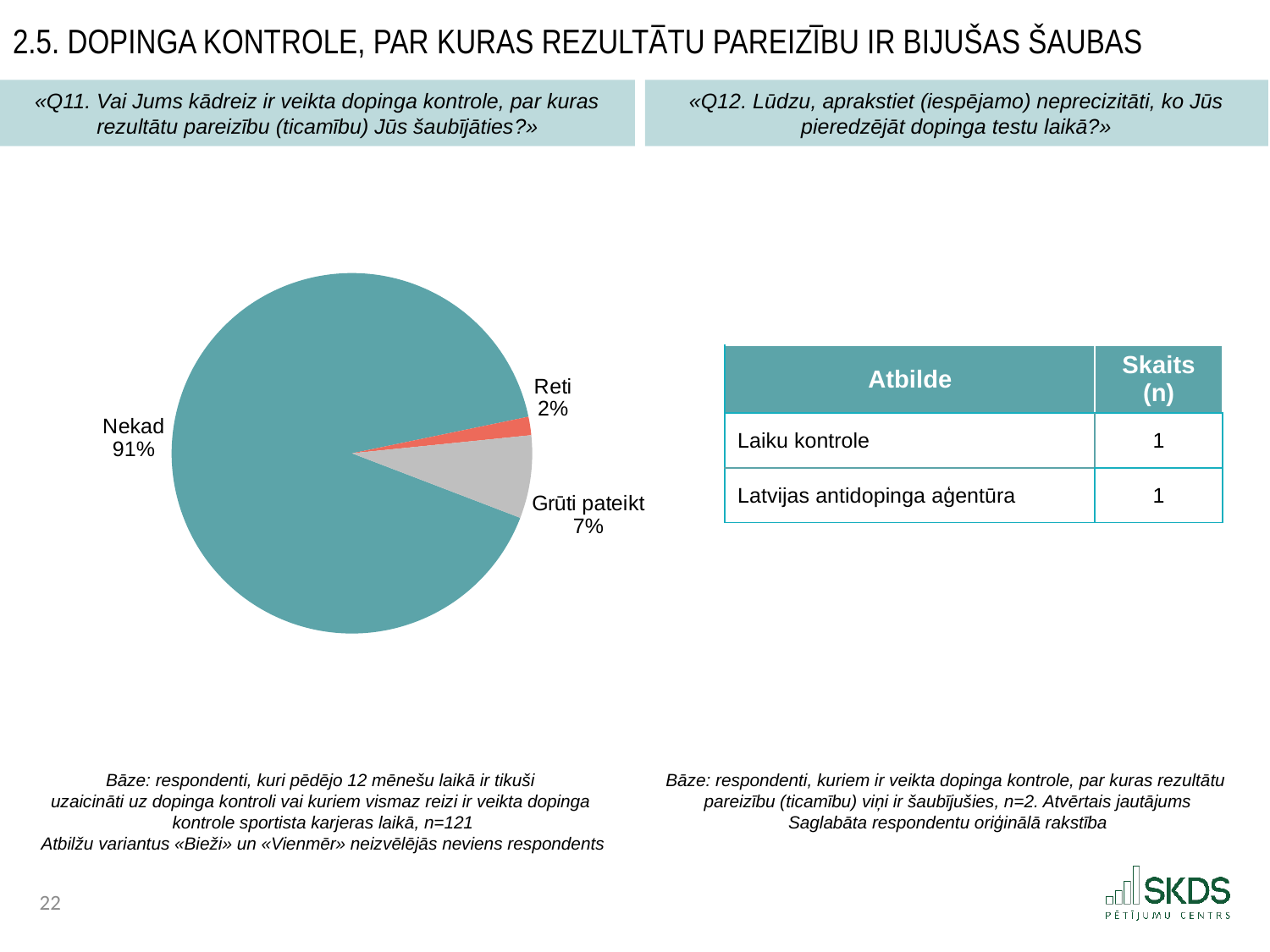
What is the value shown for "Grūti pateikt" in the pie chart? 7% Which slice is larger, "Grūti pateikt" or "Reti"? Grūti pateikt How many slices does the pie chart have? 3 What is the value shown for "Reti" in the pie chart? 2% Which category has the largest slice in the pie chart? Nekad What colour is the "Grūti pateikt" slice in the pie chart? Grey What share of the pie chart does the "Nekad" slice represent? 91% What type of chart is shown on the left side of the slide? Pie chart What colour is the "Reti" slice in the pie chart? Red What is the difference in percentage points between the "Nekad" and "Grūti pateikt" slices? 84 What is the difference in percentage points between the "Grūti pateikt" and "Reti" slices? 5 Which category has the smallest slice in the pie chart? Reti